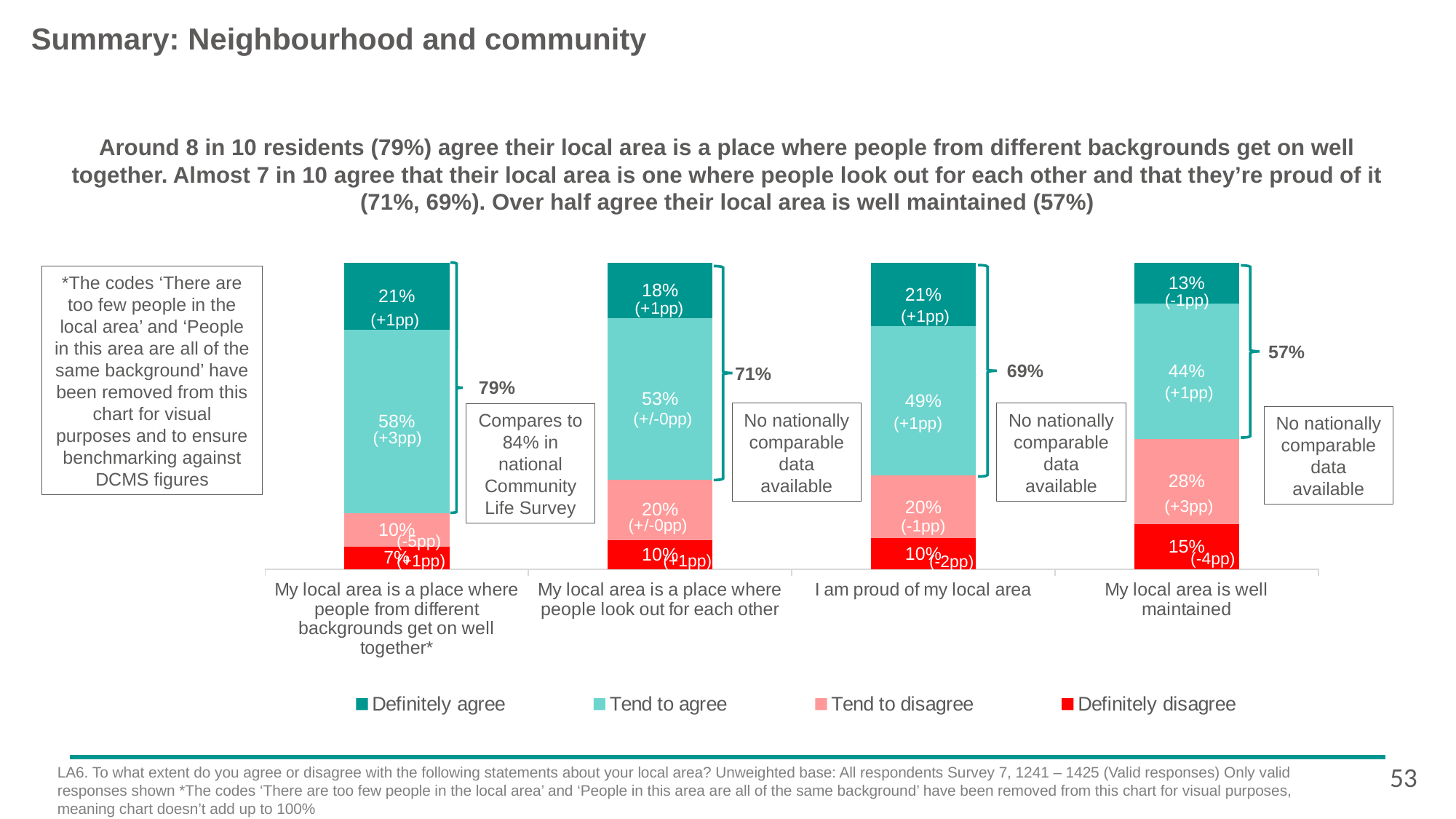
What is the 'Definitely agree' value for 'My local area is a place where people look out for each other'? 18% Which statement has the highest 'Tend to agree' percentage? My local area is a place where people from different backgrounds get on well together* What percentage of residents 'Tend to agree' that their local area is a place where people from different backgrounds get on well together? 58% What percentage 'Definitely disagree' that their local area is well maintained? 15% What is the 'Tend to disagree' value for 'I am proud of my local area'? 20% What kind of chart is shown on the slide? Stacked bar chart What is the difference between the 'Tend to agree' values for 'I am proud of my local area' and 'My local area is well maintained'? 5% How many statements (categories) are shown on the x axis of the chart? 4 How many series does the legend list? 4 What is the combined agree total (Definitely agree plus Tend to agree) shown for 'I am proud of my local area'? 69% Which is larger: the 'Tend to disagree' value for 'My local area is well maintained' or for 'My local area is a place where people look out for each other'? My local area is well maintained Which statement has the lowest 'Definitely agree' percentage? My local area is well maintained